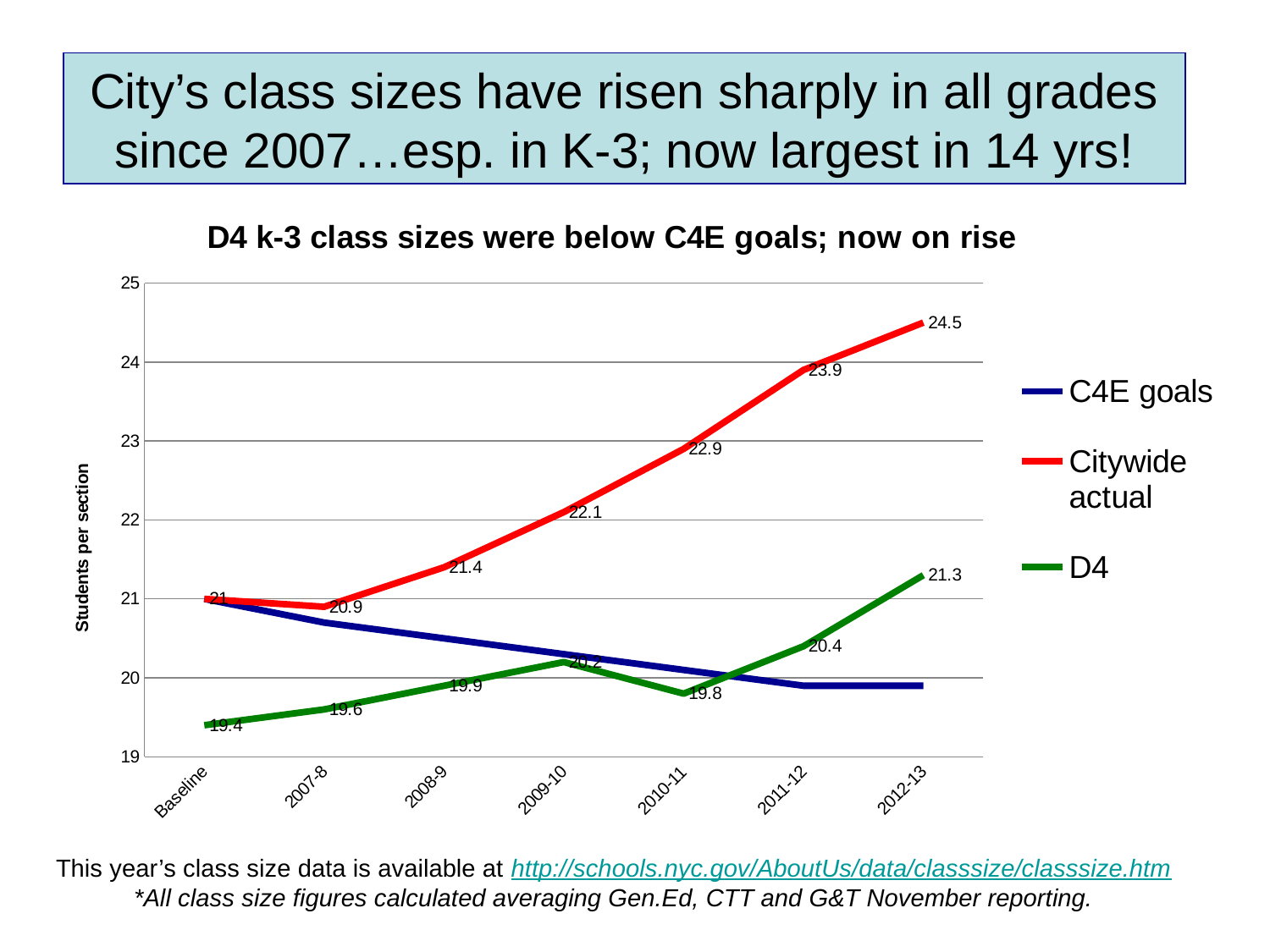
What is the D4 value at Baseline? 19.4 What kind of chart is shown on the slide? line chart At which point on the x axis is the D4 series lowest? Baseline In which year is the Citywide actual series at its highest? 2012-13 In 2011-12, which is larger: Citywide actual or D4? Citywide actual Does the Citywide actual series rise or fall from 2008-9 to 2012-13? rise How many series does the legend list? 3 By how much did the Citywide actual value increase from Baseline to 2012-13? 3.5 What is the D4 value for 2010-11? 19.8 How many categories are shown on the x axis? 7 What is the Citywide actual class size for 2012-13? 24.5